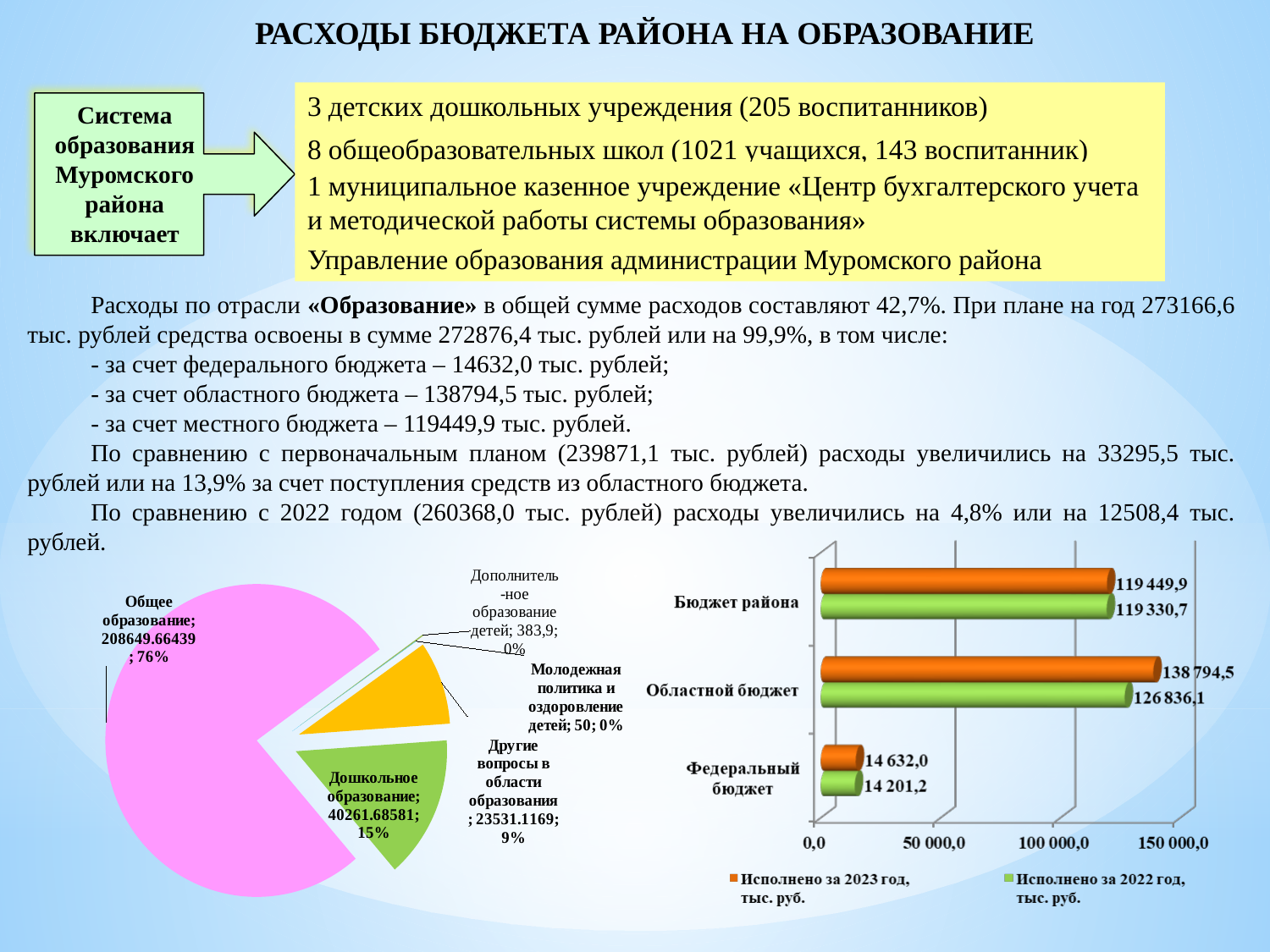
In the bar chart on the right, which category has the lowest value for Исполнено за 2023 год? Федеральный бюджет In the bar chart on the right, what is the value for Областной бюджет for Исполнено за 2023 год? 138 794,5 In the pie chart on the left, how many slices are there? 5 In the bar chart on the right, what is the difference between the 2023 and 2022 values for Областной бюджет? 11 958,4 In the bar chart on the right, how many series does the legend list? 2 In the bar chart on the right, what is the value for Федеральный бюджет for Исполнено за 2022 год? 14 201,2 In the pie chart on the left, what share does Дошкольное образование have? 15% In the bar chart on the right, which category has the highest value for Исполнено за 2022 год? Областной бюджет What kind of chart is the chart on the right of the slide? bar chart In the pie chart on the left, what is the value for Другие вопросы в области образования? 23531.1169 In the bar chart on the right, is the 2023 value for Бюджет района greater or less than 100 000,0? greater In the pie chart on the left, which slice is the largest? Общее образование